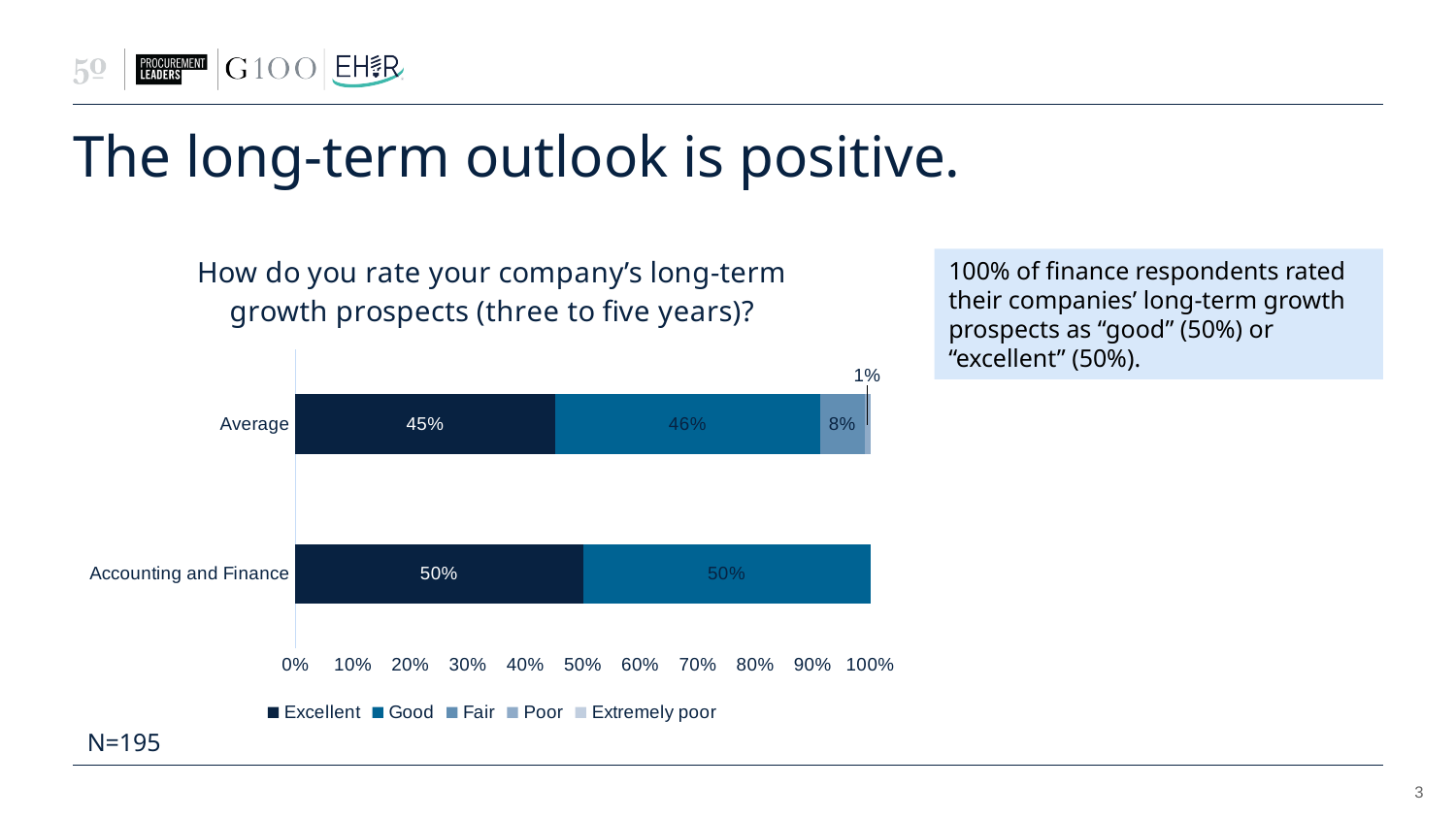
What kind of chart is shown on the slide? Stacked bar chart Which category has the higher Excellent share, Average or Accounting and Finance? Accounting and Finance What percentage of Accounting and Finance respondents rated prospects as Excellent? 50% What percentage of the Average category rated prospects as Excellent? 45% What is the difference between the Excellent share for Accounting and Finance and the Excellent share for Average? 5% What percentage of Accounting and Finance respondents rated prospects as Good? 50% How many series does the chart legend list? 5 What percentage of the Average category rated prospects as Good? 46% What is the title of the chart? How do you rate your company's long-term growth prospects (three to five years)? What percentage of the Average category rated prospects as Fair? 8% What is the sample size (N) stated on the slide? N=195 How many categories are plotted on the chart? 2